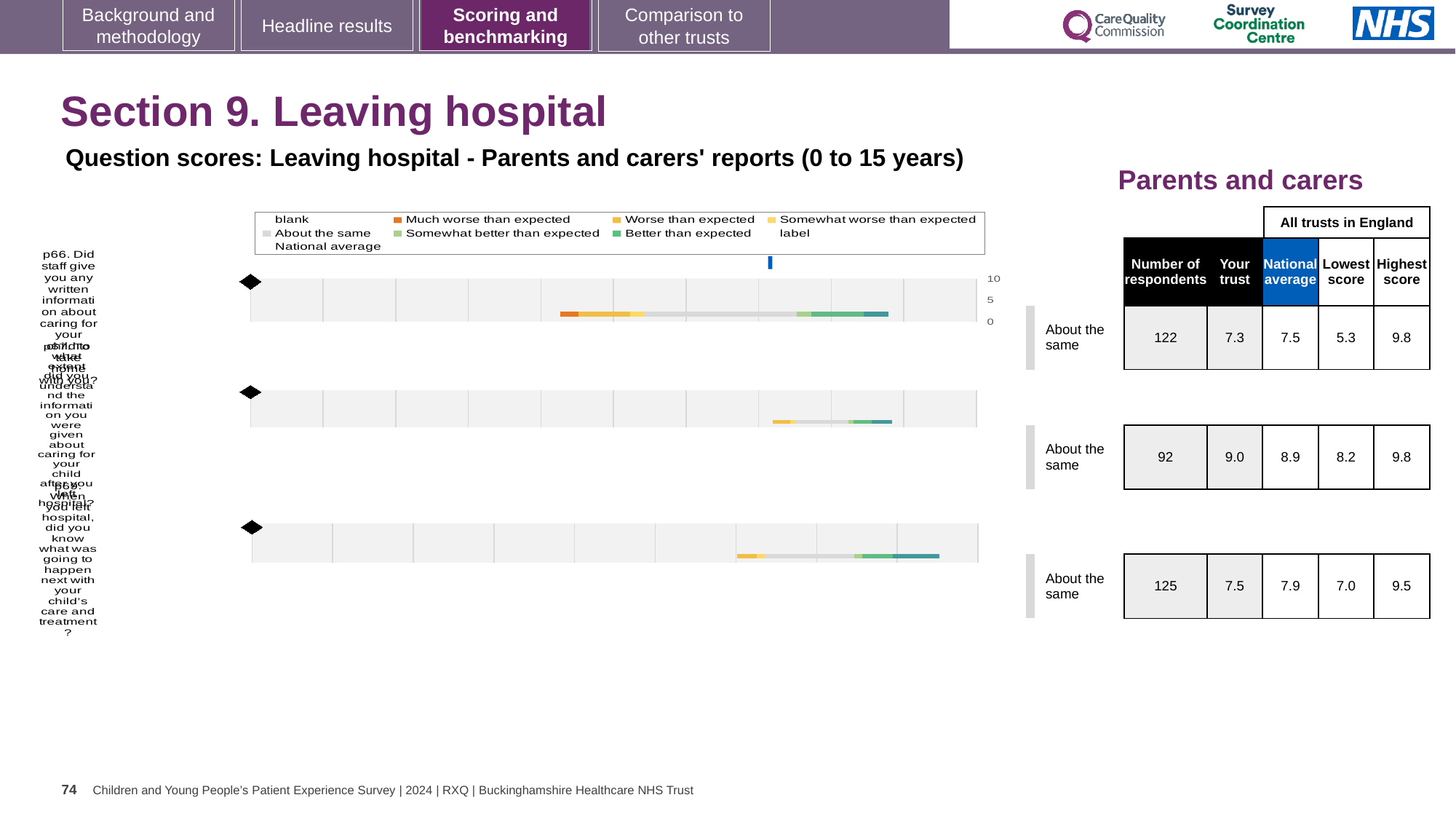
In the table for the top chart, what is the 'Your trust' score? 7.3 How many question bar charts are shown on the slide? 3 For the bottom chart, what is the difference between the national average (7.9) and the 'Your trust' score (7.5)? 0.4 In the table for the bottom chart, what is the highest score across all trusts in England? 9.5 What colour does the legend use for 'Much worse than expected'? orange In the table for the middle chart, what is the national average score? 8.9 What kind of chart is used to show the question scores on this slide? bar chart In the table for the top chart, how many respondents are listed? 122 What is the highest tick value shown on the axis of the top chart? 10 For the middle chart, is the 'Your trust' score or the national average larger? Your trust (9.0) Which of the three charts has the highest 'Your trust' score in the table? the middle chart (9.0) In the table for the top chart, what is the lowest score across all trusts in England? 5.3